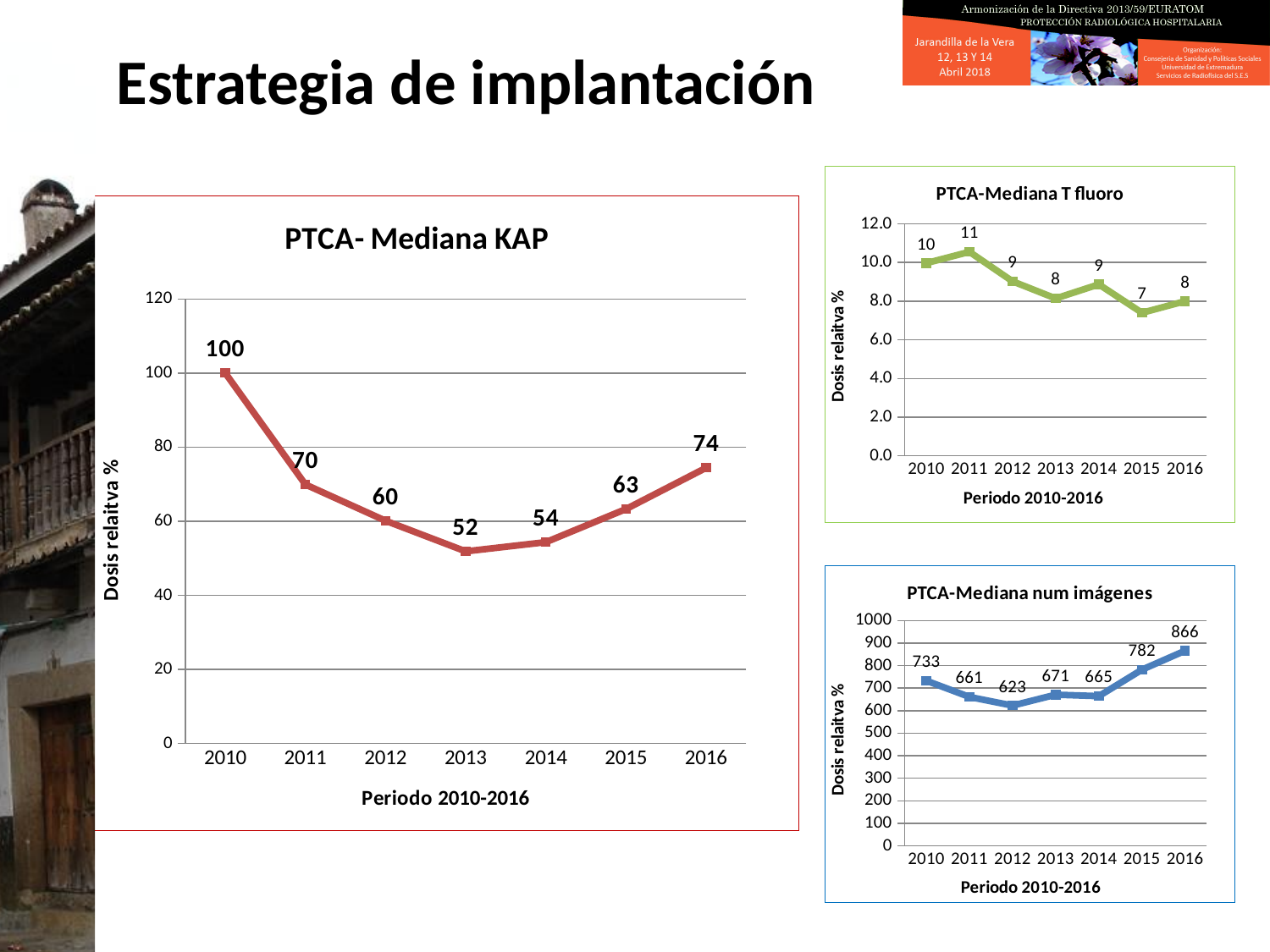
In the PTCA-Mediana T fluoro chart, what is the value for 2011? 11 In the PTCA- Mediana KAP chart, which year has the lowest value? 2013 In the PTCA-Mediana num imágenes chart, what is the value for 2016? 866 What kind of chart is the PTCA- Mediana KAP chart? Line chart In the PTCA-Mediana num imágenes chart, which year has the highest value? 2016 In the PTCA- Mediana KAP chart, what is the value for 2013? 52 In the PTCA-Mediana num imágenes chart, which is larger, the value for 2010 or the value for 2015? 2015 In the PTCA-Mediana T fluoro chart, is the value for 2010 greater or less than 8.0? greater In the PTCA-Mediana T fluoro chart, which year has the lowest value? 2015 In the PTCA- Mediana KAP chart, how many years are plotted on the x axis? 7 In the PTCA- Mediana KAP chart, what is the difference between the values for 2010 and 2016? 26 In the PTCA-Mediana num imágenes chart, what is the difference between the values for 2015 and 2012? 159